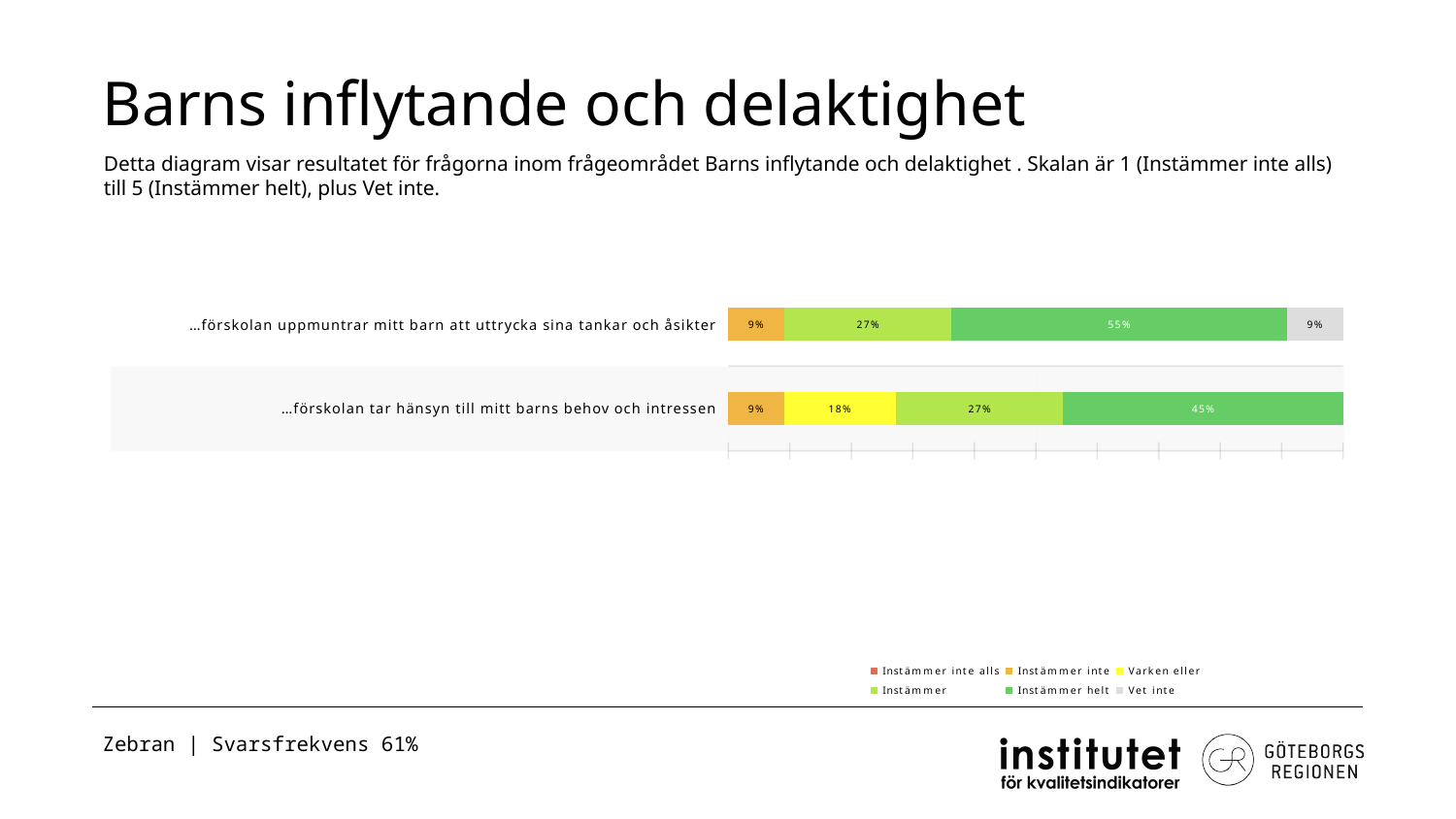
What is the 'Instämmer helt' value for '…förskolan uppmuntrar mitt barn att uttrycka sina tankar och åsikter'? 55% What is the difference between the 'Instämmer helt' values of the two categories? 10% What is the 'Varken eller' value for '…förskolan tar hänsyn till mitt barns behov och intressen'? 18% How many categories (questions) are plotted in the chart? 2 Which legend entry is shown in grey? Vet inte How many series does the legend list? 6 What is the 'Instämmer helt' value for '…förskolan tar hänsyn till mitt barns behov och intressen'? 45% Which category has the higher 'Instämmer helt' value? …förskolan uppmuntrar mitt barn att uttrycka sina tankar och åsikter Is the 'Instämmer' value larger for '…förskolan uppmuntrar mitt barn att uttrycka sina tankar och åsikter' or for '…förskolan tar hänsyn till mitt barns behov och intressen'? They are equal (27%) What kind of chart is shown on the slide? stacked bar chart What is the 'Vet inte' value for '…förskolan uppmuntrar mitt barn att uttrycka sina tankar och åsikter'? 9% What is the total of the labelled segments in the bar for '…förskolan tar hänsyn till mitt barns behov och intressen'? 99%